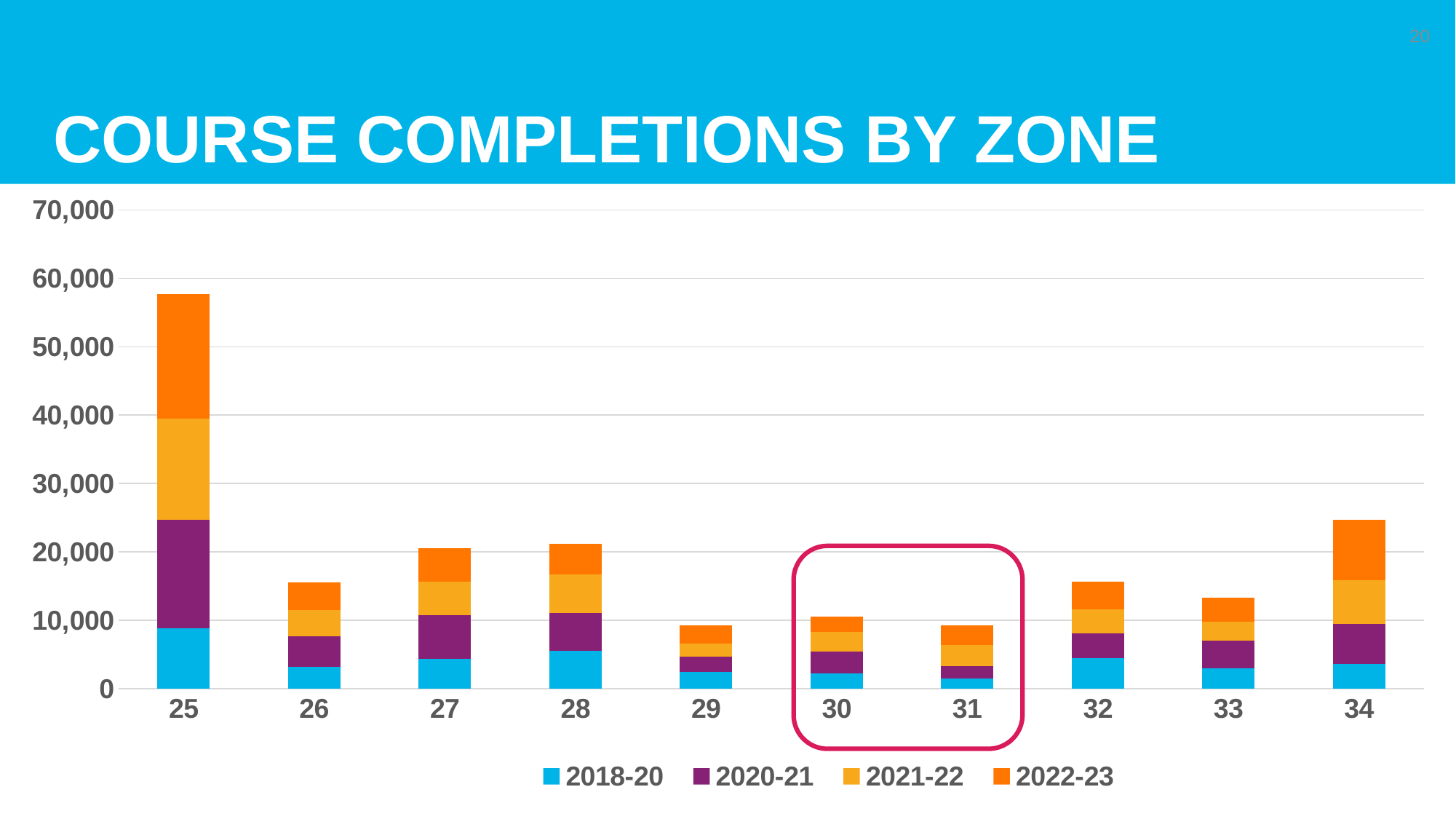
Is the total for zone 32 greater or less than 10,000? greater Which two zones are highlighted by the outlined box on the chart? 30 and 31 How many series does the legend list? 4 Is the total for zone 25 greater or less than 50,000? greater Is the total for zone 33 greater or less than 20,000? less Which zone has the larger total, zone 34 or zone 26? 34 What kind of chart is shown on the slide? Stacked bar chart Which zone has the larger total, zone 28 or zone 29? 28 Which zone has the highest total course completions? 25 How many zones are shown on the x axis of the chart? 10